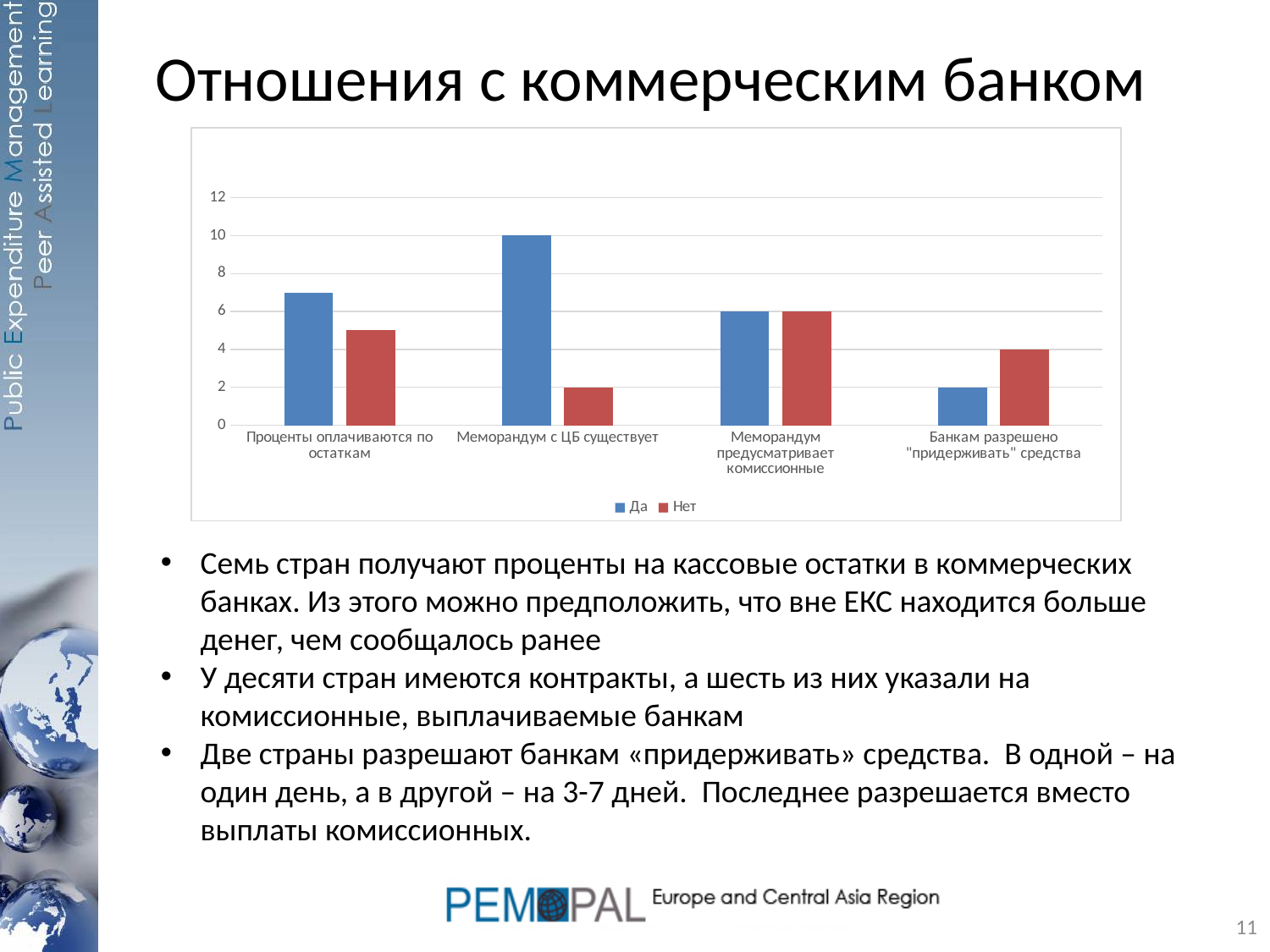
What is the value of "Да" for "Меморандум предусматривает комиссионные"? 6 How many categories are shown on the x axis? 4 How many series does the legend list? 2 What is the value of "Да" for "Меморандум с ЦБ существует"? 10 Is the "Да" value for "Проценты оплачиваются по остаткам" greater or less than 6? greater What is the value of "Нет" for "Меморандум с ЦБ существует"? 2 What kind of chart is shown on the slide? bar chart What is the value of "Нет" for "Банкам разрешено "придерживать" средства"? 4 Which category has the highest "Да" value? Меморандум с ЦБ существует Which is larger for "Банкам разрешено "придерживать" средства": "Да" or "Нет"? Нет What is the difference between "Да" and "Нет" for "Меморандум с ЦБ существует"? 8 Which category has the lowest "Да" value? Банкам разрешено "придерживать" средства